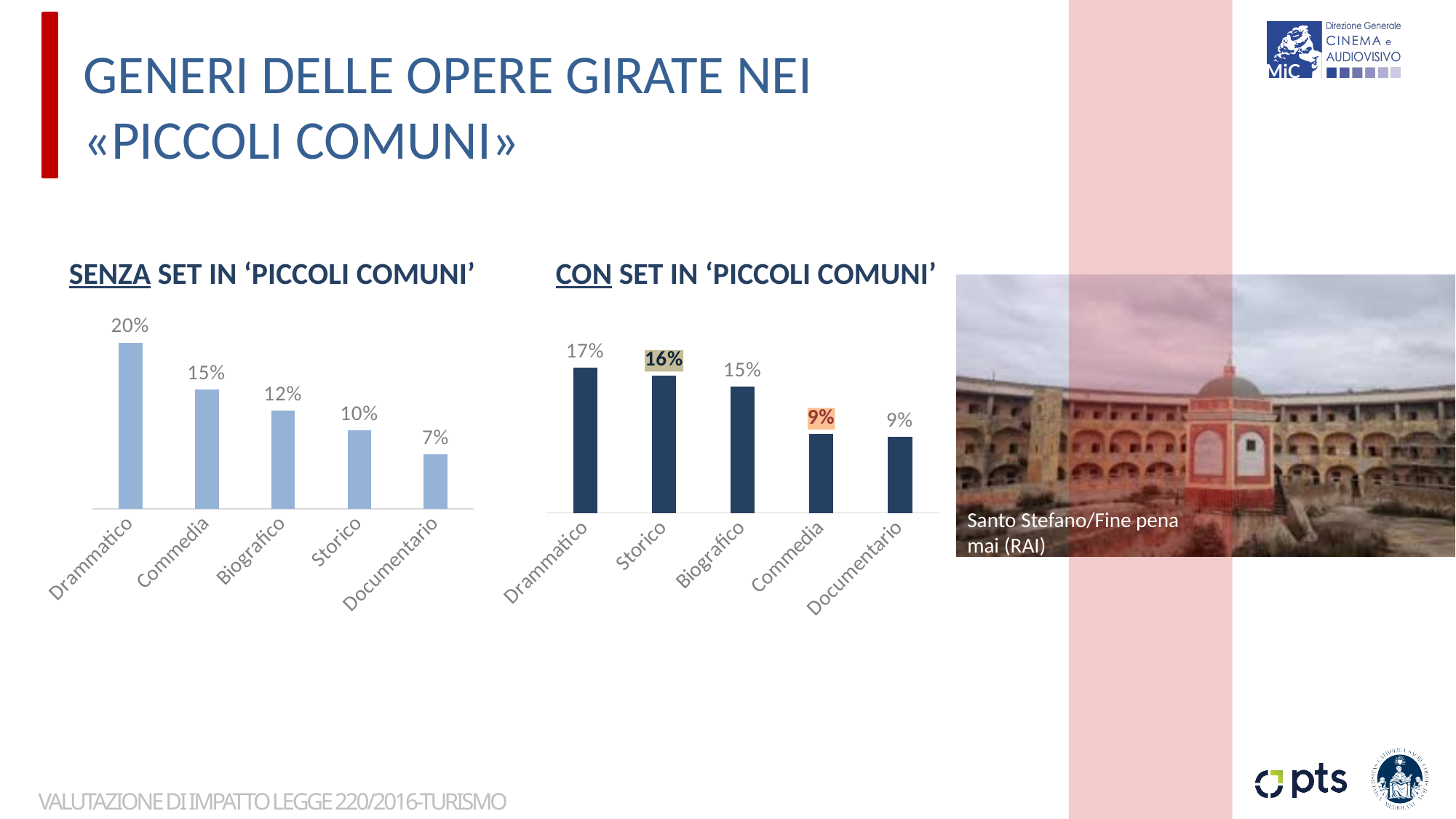
In the 'SENZA SET IN PICCOLI COMUNI' chart, what is the difference between Drammatico and Commedia? 5% In the 'CON SET IN PICCOLI COMUNI' chart, which is larger, Storico or Biografico? Storico In the 'SENZA SET IN PICCOLI COMUNI' chart, which is larger, Biografico or Storico? Biografico How many categories are shown in the 'SENZA SET IN PICCOLI COMUNI' chart? 5 In the 'CON SET IN PICCOLI COMUNI' chart, which category has the highest value? Drammatico In the 'CON SET IN PICCOLI COMUNI' chart, what is the value for Storico? 16% In the 'CON SET IN PICCOLI COMUNI' chart, what is the difference between Drammatico and Documentario? 8% In the 'SENZA SET IN PICCOLI COMUNI' chart, do the values rise or fall from left to right? Fall In the 'SENZA SET IN PICCOLI COMUNI' chart, what is the value for Drammatico? 20% In the 'SENZA SET IN PICCOLI COMUNI' chart, which category has the lowest value? Documentario In the 'CON SET IN PICCOLI COMUNI' chart, what is the value for Commedia? 9% What kind of chart is the 'CON SET IN PICCOLI COMUNI' chart? Bar chart